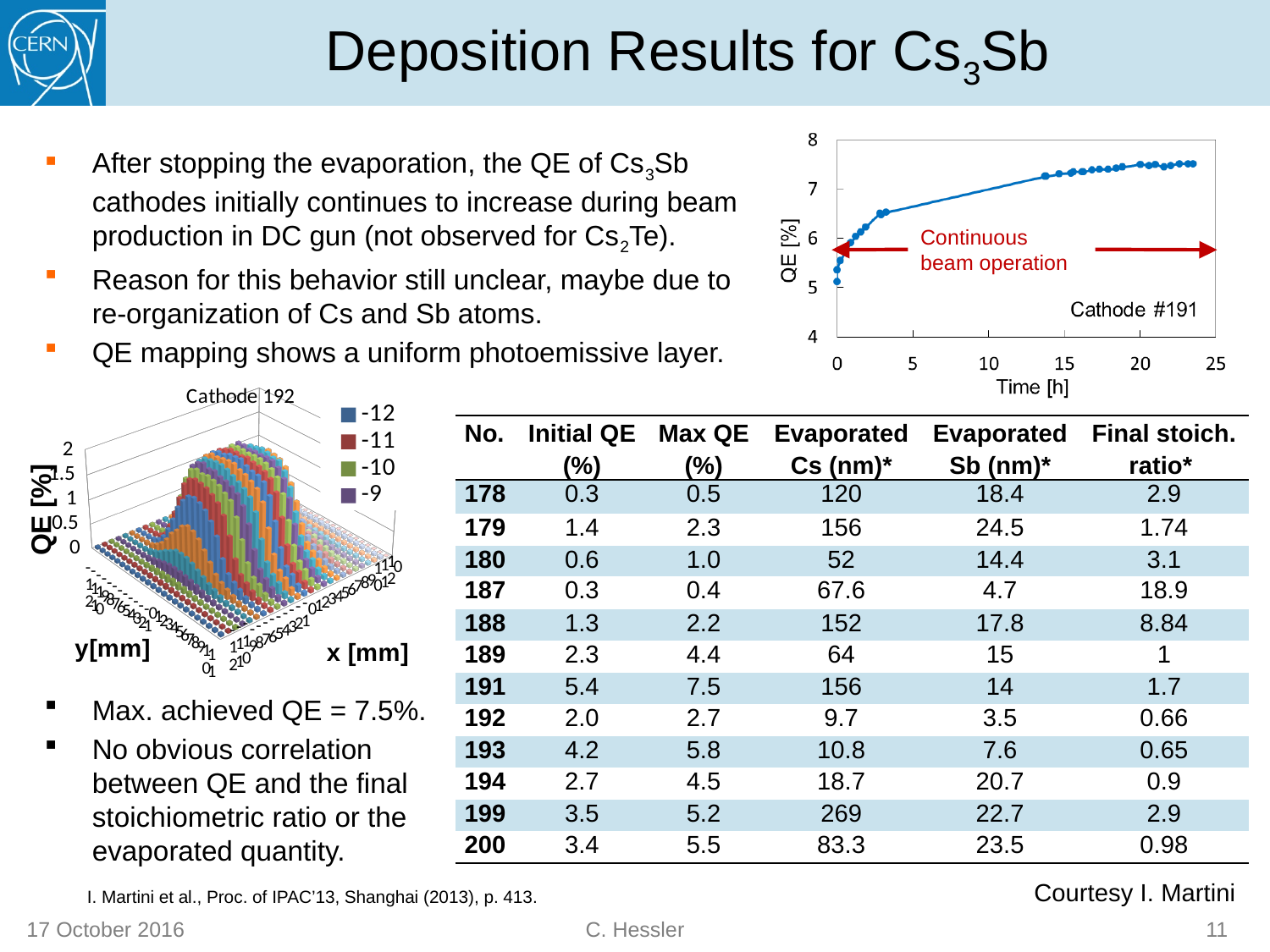
In the 'Cathode #191' chart, is the QE value at time 0 greater or less than 6? less In the 'Cathode #191' chart, is the QE value at the last plotted point (around 23 h) greater or less than 7? greater What is the title of the 3D chart in the lower left of the slide? Cathode 192 In the 'Cathode #191' chart, is the QE value at about 3 h greater or less than 7? less In the 'Cathode #191' chart, does the QE rise or fall as time increases? rise What is the highest tick value shown on the y axis of the 'Cathode #191' chart? 8 How many legend entries are visible in the 'Cathode 192' chart? 4 What kind of chart is the 'Cathode 192' chart in the lower left of the slide? 3D bar chart What kind of chart is the 'Cathode #191' chart in the upper right of the slide? line chart In the chart titled 'Cathode #191', what quantity is plotted on the x axis? Time [h] In the 'Cathode #191' chart, which is larger: the QE at about 15 h or the QE at about 3 h? the QE at about 15 h